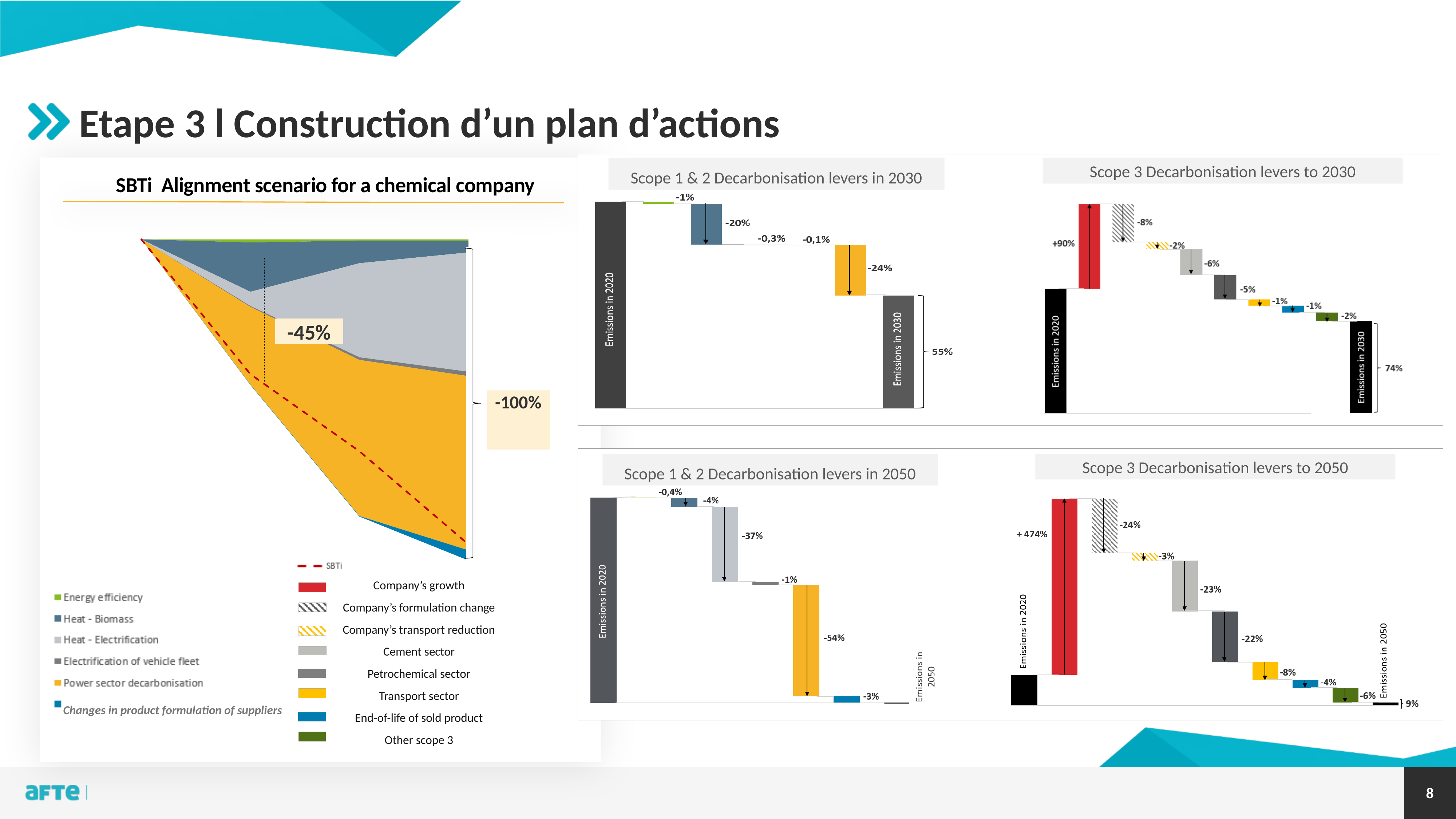
In the 'Scope 1 & 2 Decarbonisation levers in 2030' chart, what is the largest single reduction shown? -24% In the 'Scope 3 Decarbonisation levers to 2030' chart, what is the value of the red Company's growth bar? +90% In the 'Scope 1 & 2 Decarbonisation levers in 2050' chart, what is the value of the light grey Heat - Electrification bar? -37% In the 'SBTi Alignment scenario for a chemical company' chart, what two reduction percentages are labelled on the chart? -45% and -100% In the 'Scope 3 Decarbonisation levers to 2030' chart, what is the value of the hatched grey Company's formulation change bar? -8% In the 'Scope 1 & 2 Decarbonisation levers in 2050' chart, what is the largest single reduction shown? -54% In the 'Scope 1 & 2 Decarbonisation levers in 2030' chart, what percentage of 2020 emissions remain in 2030? 55% In the 'Scope 3 Decarbonisation levers to 2030' chart, what percentage is labelled for Emissions in 2030? 74% In the 'Scope 1 & 2 Decarbonisation levers in 2030' chart, which lever gives the larger reduction: the dark blue bar (Heat - Biomass, -20%) or the orange bar (Power sector decarbonisation, -24%)? Power sector decarbonisation In the 'Scope 3 Decarbonisation levers to 2050' chart, what percentage is labelled for Emissions in 2050? 9% What is the difference in percentage points between the Emissions in 2030 label in the Scope 3 chart (74%) and the Emissions in 2030 label in the Scope 1 & 2 chart (55%)? 19 percentage points In the 'Scope 3 Decarbonisation levers to 2050' chart, what is the value of the red Company's growth bar? + 474%